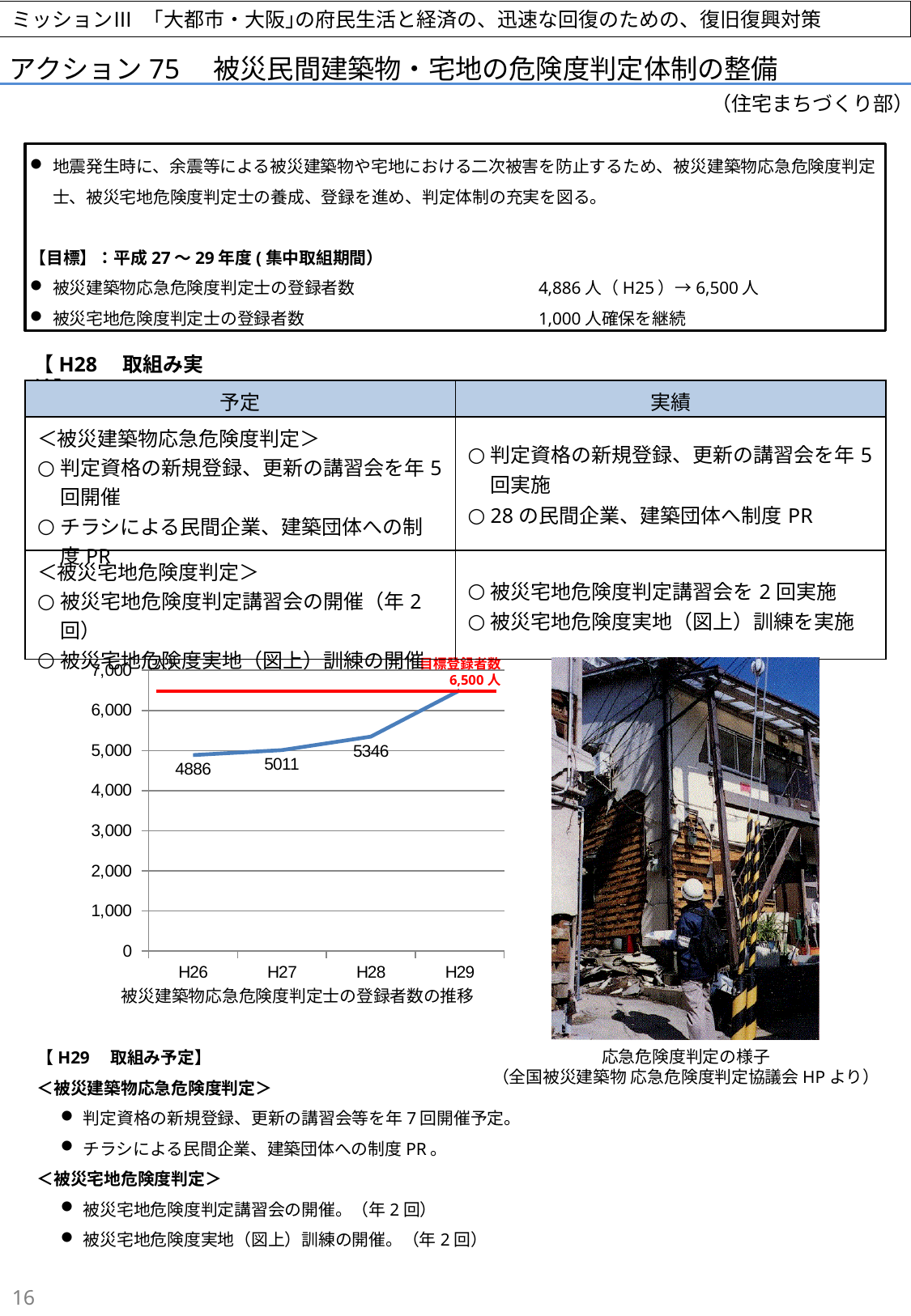
Do the plotted values rise or fall from H26 to H29? rise What is the difference between the H27 and H26 values in the chart? 125 What target value (目標登録者数) is marked by the red line on the chart? 6,500人 How many years are shown on the x axis of the chart? 4 Is the value plotted for H29 greater or less than 6,000? greater By how much did the plotted value increase from H26 to H28? 460 What is the value plotted for H28 in the line chart? 5346 Which year has a higher plotted value, H27 or H28? H28 What is the value plotted for H26 in the line chart? 4886 What kind of chart is shown on the slide? line chart Which year has the lowest plotted value in the chart? H26 What is the value plotted for H27 in the line chart? 5011